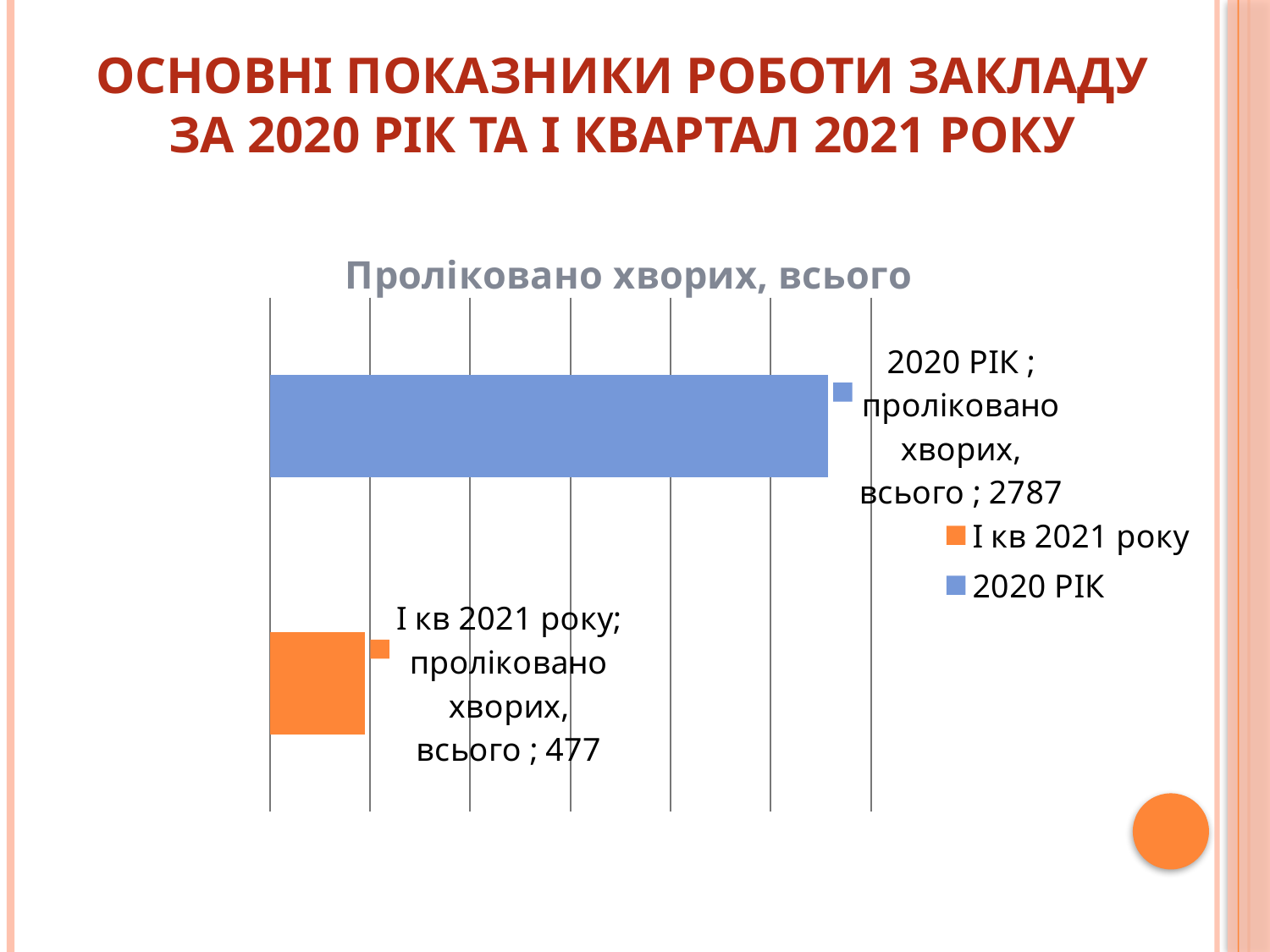
What is the difference between the values for 2020 РІК and I кв 2021 року in the chart? 2310 How many series does the legend of the chart list? 2 What is the total of the two values shown in the chart "Проліковано хворих, всього"? 3264 What colour is the bar for I кв 2021 року in the chart? Orange Which series has the lowest value in the chart "Проліковано хворих, всього"? I кв 2021 року What is the value for 2020 РІК in the chart "Проліковано хворих, всього"? 2787 Which is larger in the chart: the value for 2020 РІК or the value for I кв 2021 року? 2020 РІК How many bars are plotted in the chart "Проліковано хворих, всього"? 2 What kind of chart is shown on the slide? Bar chart What is the value for I кв 2021 року in the chart "Проліковано хворих, всього"? 477 What is the title of the chart on the slide? Проліковано хворих, всього Which series has the highest value in the chart "Проліковано хворих, всього"? 2020 РІК